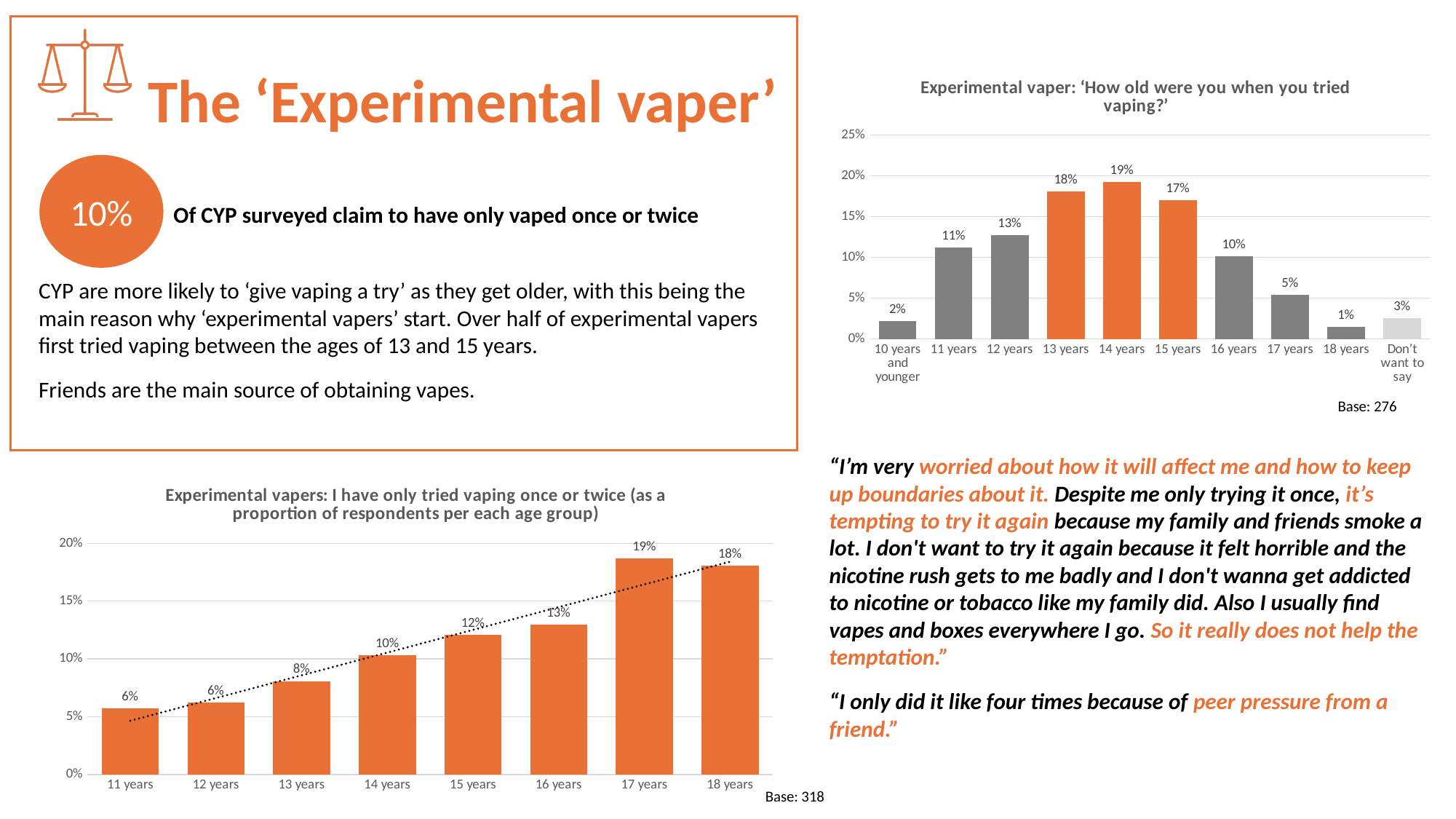
In the chart 'Experimental vaper: How old were you when you tried vaping?', which age category has the highest value? 14 years In the chart 'Experimental vaper: How old were you when you tried vaping?', what is the value for 'Don't want to say'? 3% In the chart 'Experimental vapers: I have only tried vaping once or twice', do the values generally rise or fall from 11 years to 18 years? rise In the chart 'Experimental vapers: I have only tried vaping once or twice', which age group has the highest value? 17 years What type of chart is 'Experimental vapers: I have only tried vaping once or twice'? bar chart In the chart 'Experimental vaper: How old were you when you tried vaping?', which category has the lowest value? 18 years In the chart 'Experimental vapers: I have only tried vaping once or twice', what is the value for 15 years? 12% In the chart 'Experimental vaper: How old were you when you tried vaping?', how many categories are shown on the x axis? 10 In the chart 'Experimental vaper: How old were you when you tried vaping?', which bars are coloured orange? 13 years, 14 years and 15 years In the chart 'Experimental vapers: I have only tried vaping once or twice', what is the difference between the values for 18 years and 11 years? 12% In the chart 'Experimental vaper: How old were you when you tried vaping?', what is the value for 14 years? 19% In the chart 'Experimental vaper: How old were you when you tried vaping?', what is the difference between the values for 13 years and 16 years? 8%